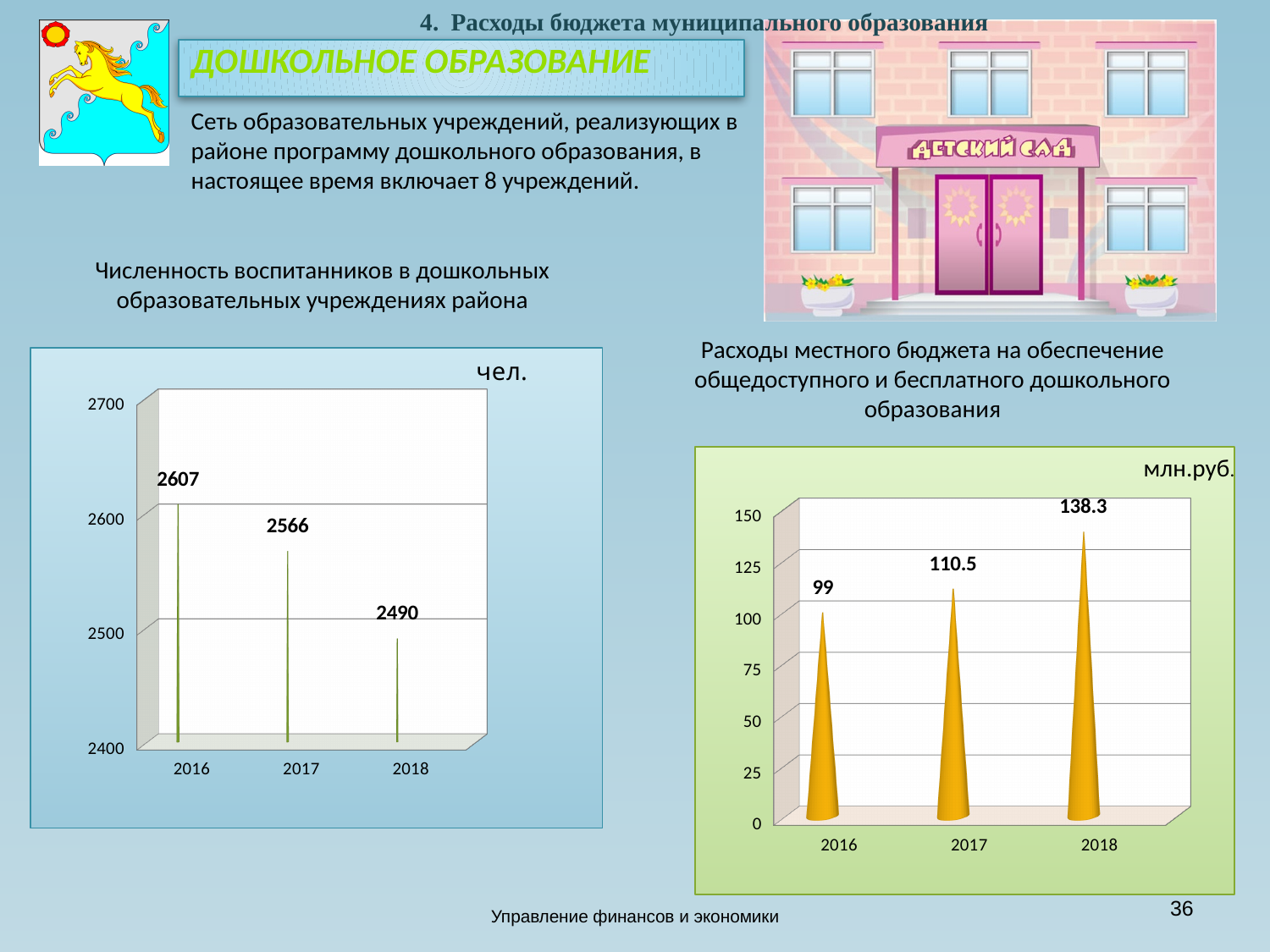
On the left chart (Численность воспитанников), what is the difference between the 2016 and 2018 values? 117 What kind of chart is the right chart (Расходы местного бюджета)? bar chart On the left chart (Численность воспитанников), do the values rise or fall from 2016 to 2018? fall On the left chart (Численность воспитанников), what unit is shown in the top right corner? чел. On the right chart (Расходы местного бюджета), what is the difference between the 2018 and 2016 values? 39.3 On the left chart (Численность воспитанников), what is the value for 2016? 2607 On the right chart (Расходы местного бюджета), how many years are plotted? 3 On the right chart (Расходы местного бюджета), what is the value for 2017? 110.5 On the right chart (Расходы местного бюджета), is the value for 2016 larger or smaller than the value for 2017? smaller On the left chart (Численность воспитанников), which year has the lowest value? 2018 On the left chart (Численность воспитанников), what is the value for 2018? 2490 On the right chart (Расходы местного бюджета), which year has the highest value? 2018